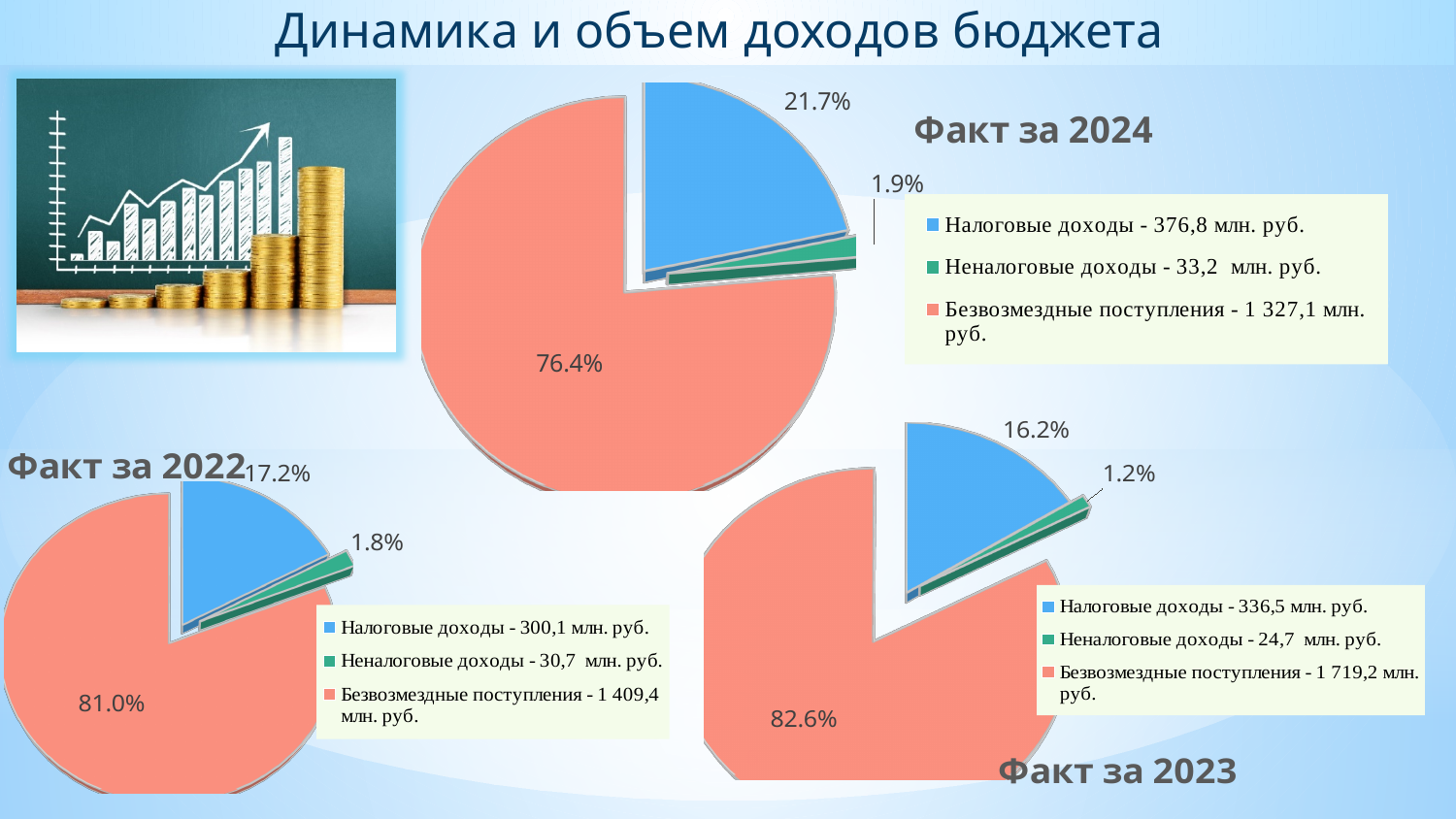
On the 'Факт за 2022' pie chart, what value in млн. руб. does the legend give for 'Безвозмездные поступления'? 1 409,4 млн. руб. On the 'Факт за 2022' pie chart, which category has the smallest share? Неналоговые доходы On the 'Факт за 2023' pie chart, which category has the largest share? Безвозмездные поступления On the 'Факт за 2024' pie chart, what is the difference in percentage points between the shares of 'Безвозмездные поступления' and 'Налоговые доходы'? 54.7 On the 'Факт за 2024' pie chart, what value in млн. руб. does the legend give for 'Неналоговые доходы'? 33,2 млн. руб. What type of chart is used for 'Факт за 2022'? Pie chart On the 'Факт за 2022' pie chart, what share does 'Налоговые доходы' have? 17.2% How many slices does the 'Факт за 2023' pie chart have? 3 On the 'Факт за 2023' pie chart, what share does 'Неналоговые доходы' have? 1.2% On the 'Факт за 2024' pie chart, what share does 'Безвозмездные поступления' have? 76.4% On the 'Факт за 2023' pie chart, what value in млн. руб. does the legend give for 'Налоговые доходы'? 336,5 млн. руб.